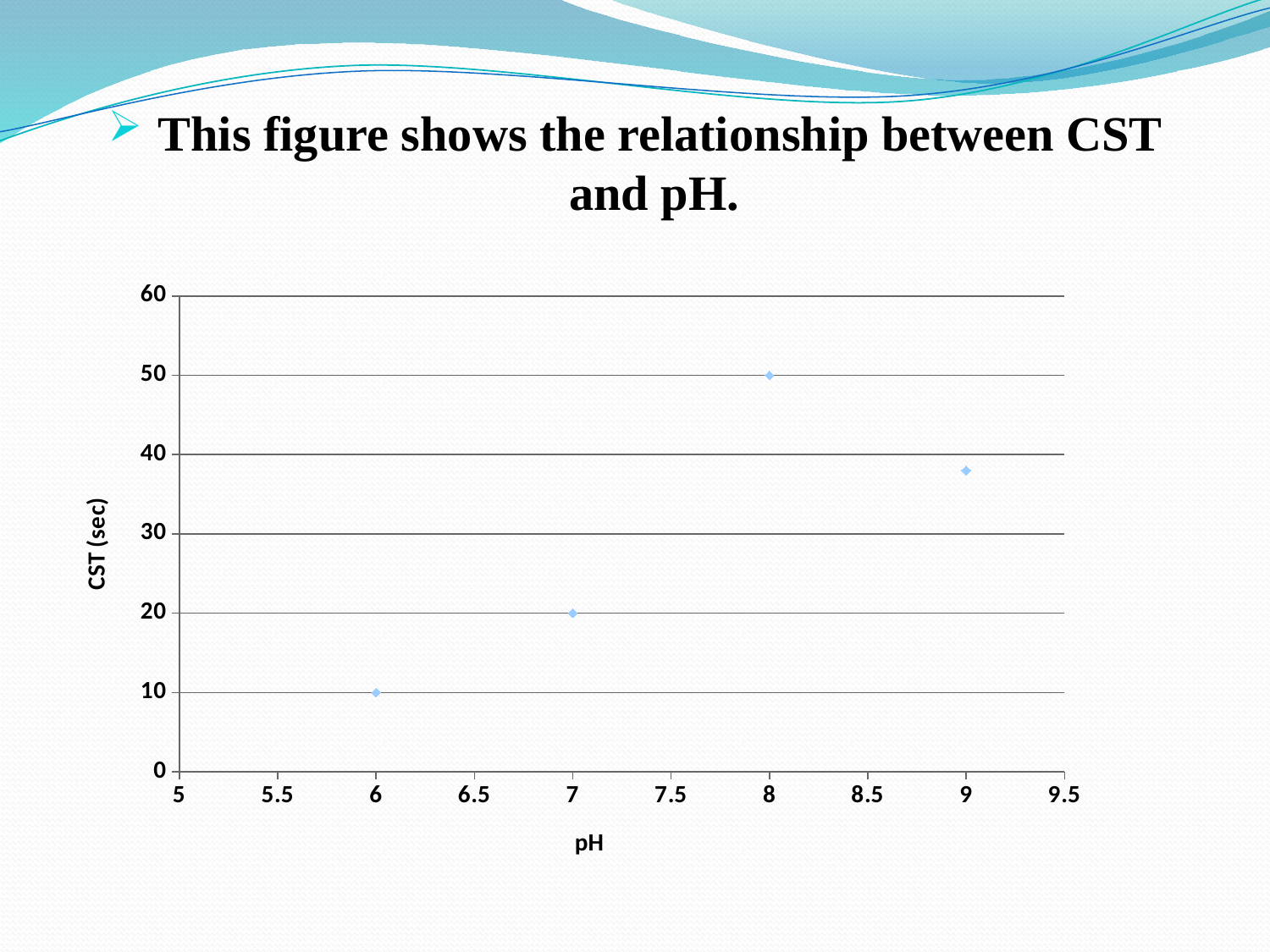
What is the CST (sec) value at pH 7? 20 What is the CST (sec) value at pH 8? 50 What is the label of the vertical axis? CST (sec) How many data points are plotted on the chart? 4 What kind of chart is shown on the slide? scatter chart At which pH is the CST value lowest? 6 At which pH is the CST value highest? 8 Which has a larger CST value, pH 8 or pH 9? pH 8 What is the difference between the CST values at pH 8 and pH 6? 40 Is the CST value at pH 9 greater or less than 40? less Do the CST values rise or fall from pH 6 to pH 8? rise What is the CST (sec) value at pH 6? 10